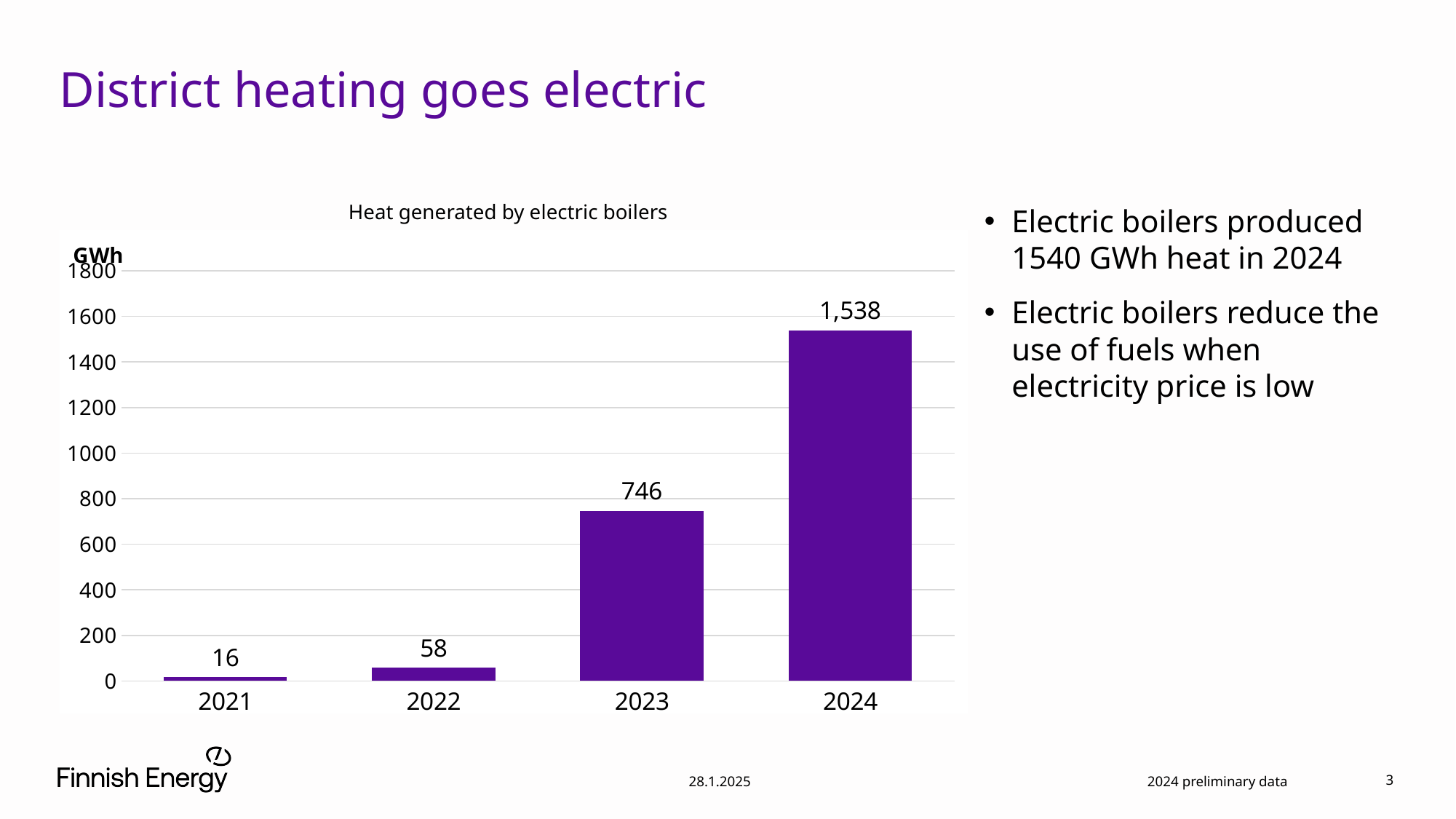
What is the value for 2024? 1,538 Which year has the highest value? 2024 Is the value for 2023 greater or less than 800? less What is the value for 2022? 58 What is the value for 2021? 16 Do the values rise or fall from 2021 to 2024? rise What is the difference between the values for 2024 and 2023? 792 What is the value for 2023? 746 How many years are shown on the x axis? 4 Which is larger, the value for 2022 or the value for 2023? 2023 Which year has the lowest value? 2021 What kind of chart is this? bar chart